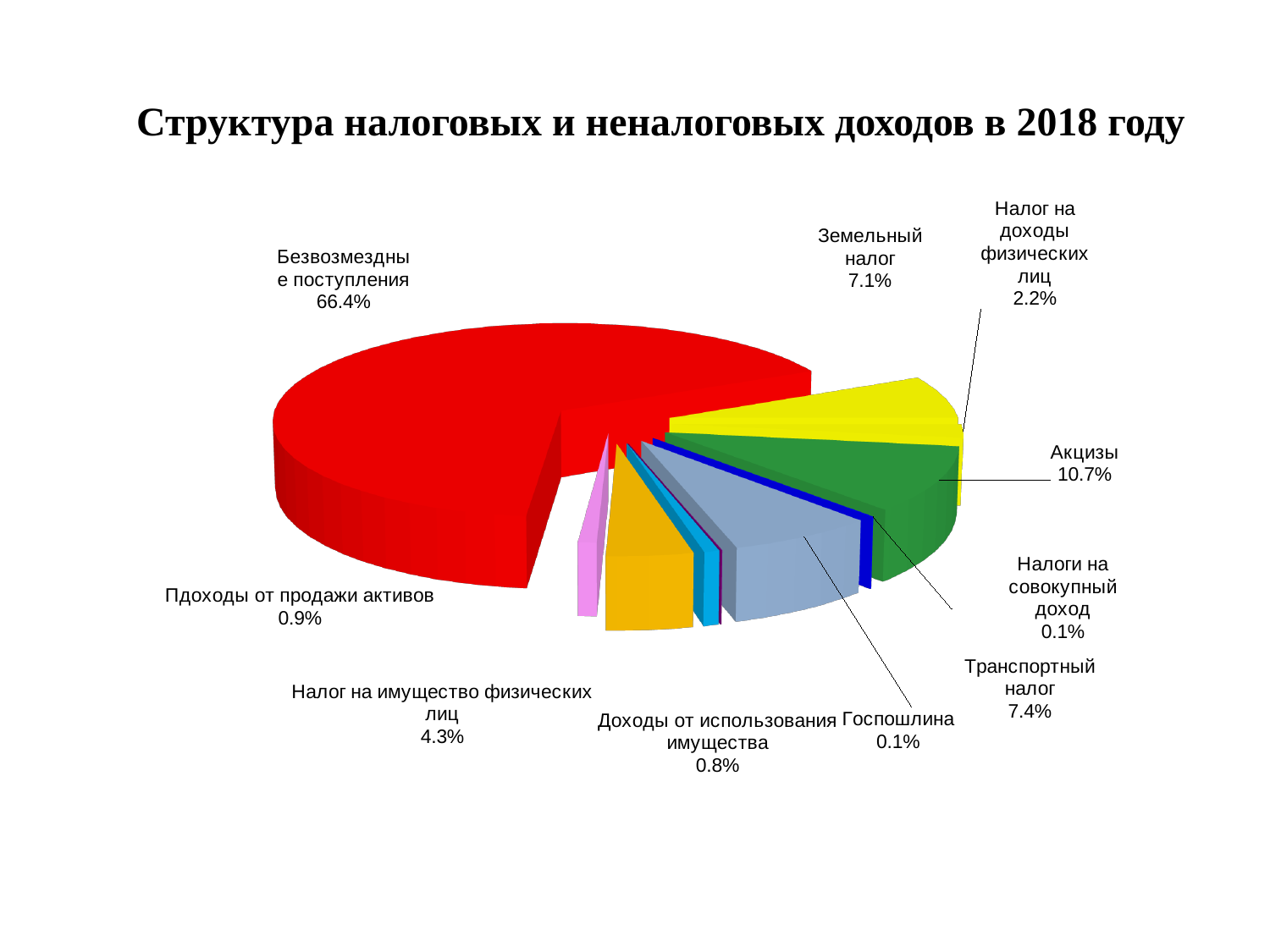
What is the title of the chart? Структура налоговых и неналоговых доходов в 2018 году What kind of chart is shown on the slide? Pie chart How many categories (slices) does the pie chart have? 10 What is the value shown for Налог на доходы физических лиц? 2.2% Which category has the largest share of the pie? Безвозмездные поступления What is the difference between the shares of Налог на имущество физических лиц and Доходы от использования имущества? 3.5% What is the value shown for Акцизы? 10.7% What share of the pie is Безвозмездные поступления? 66.4% What is the difference between the shares of Акцизы and Земельный налог? 3.6% Which is larger, Земельный налог or Транспортный налог? Транспортный налог What is the value shown for Транспортный налог? 7.4% What is the value shown for Налог на имущество физических лиц? 4.3%